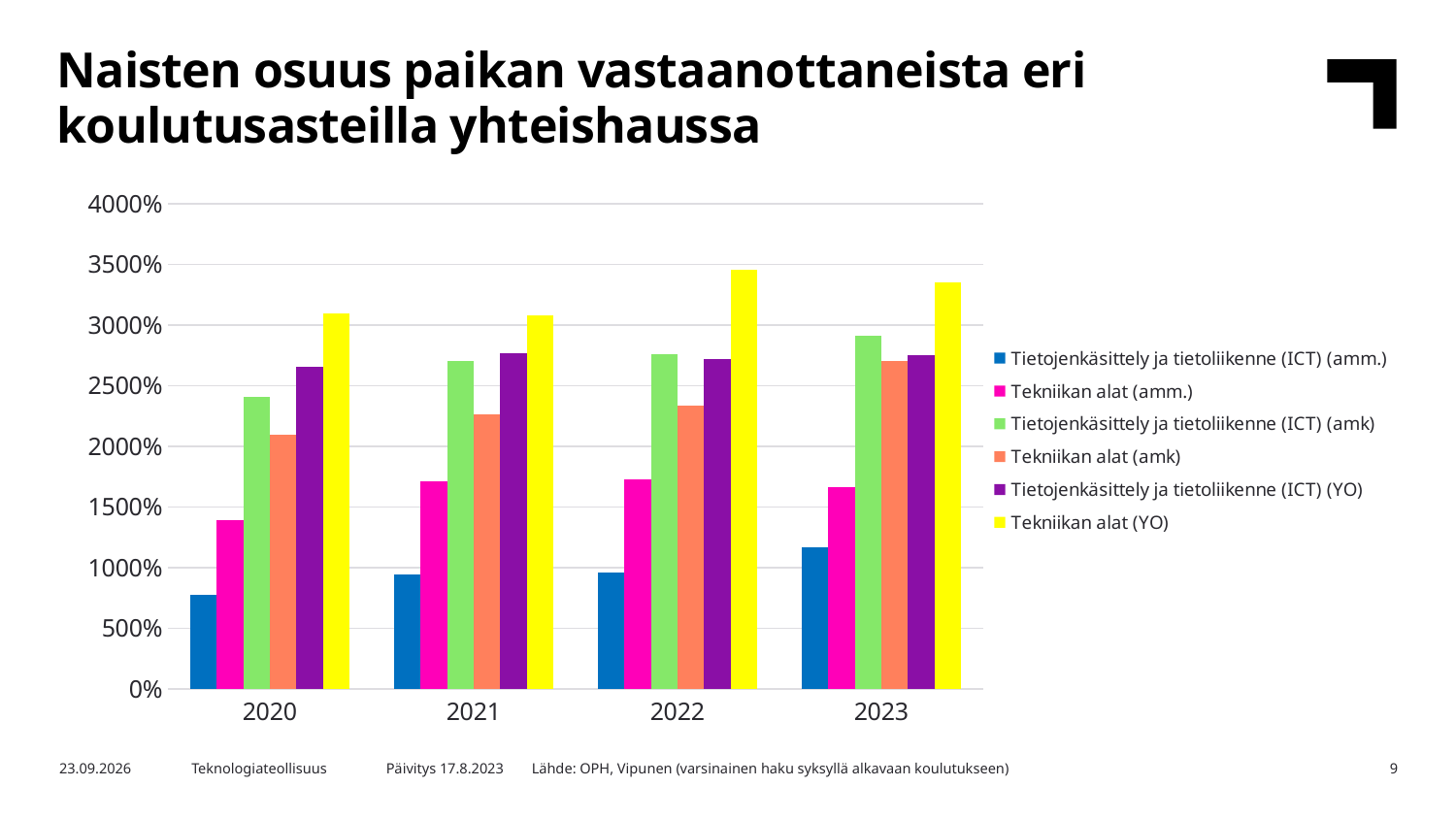
What kind of chart is shown on the slide? Bar chart In 2020, which is larger: Tietojenkäsittely ja tietoliikenne (ICT) (amk) or Tekniikan alat (amk)? Tietojenkäsittely ja tietoliikenne (ICT) (amk) How many series does the legend list? 6 Is the value for Tekniikan alat (amm.) in 2023 greater or less than 2000%? less Is the value for Tietojenkäsittely ja tietoliikenne (ICT) (amm.) in 2020 greater or less than 1000%? less Is the value for Tekniikan alat (YO) in 2022 greater or less than 3000%? greater In 2023, which is larger: Tietojenkäsittely ja tietoliikenne (ICT) (amk) or Tietojenkäsittely ja tietoliikenne (ICT) (YO)? Tietojenkäsittely ja tietoliikenne (ICT) (amk) How many years are shown on the x axis? 4 Does the value for Tietojenkäsittely ja tietoliikenne (ICT) (amm.) rise or fall from 2020 to 2023? rise What colour represents Tekniikan alat (YO) in the chart? Yellow In which year is the value for Tekniikan alat (YO) the highest? 2022 Which series has the lowest value in 2020? Tietojenkäsittely ja tietoliikenne (ICT) (amm.)